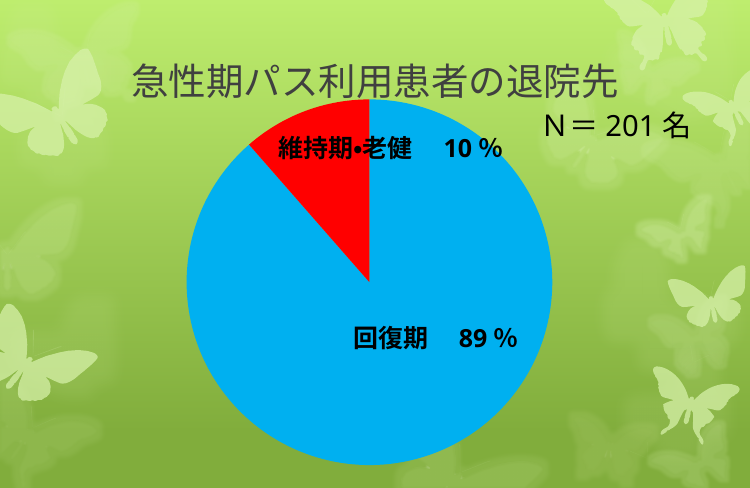
What colour is the 維持期・老健 slice? red Which category has the largest slice of the pie? 回復期 What share of the pie does 維持期・老健 account for? 10% What is the value of N shown on the slide? 201名 What kind of chart is shown on the slide? pie chart Which category has the smallest labeled slice of the pie? 維持期・老健 What is the difference in percentage points between the 回復期 share and the 維持期・老健 share? 79 How many labeled categories are shown in the pie chart? 2 What is the title of the chart? 急性期パス利用患者の退院先 What share of the pie does 回復期 account for? 89% Which is larger, the share for 回復期 or the share for 維持期・老健? 回復期